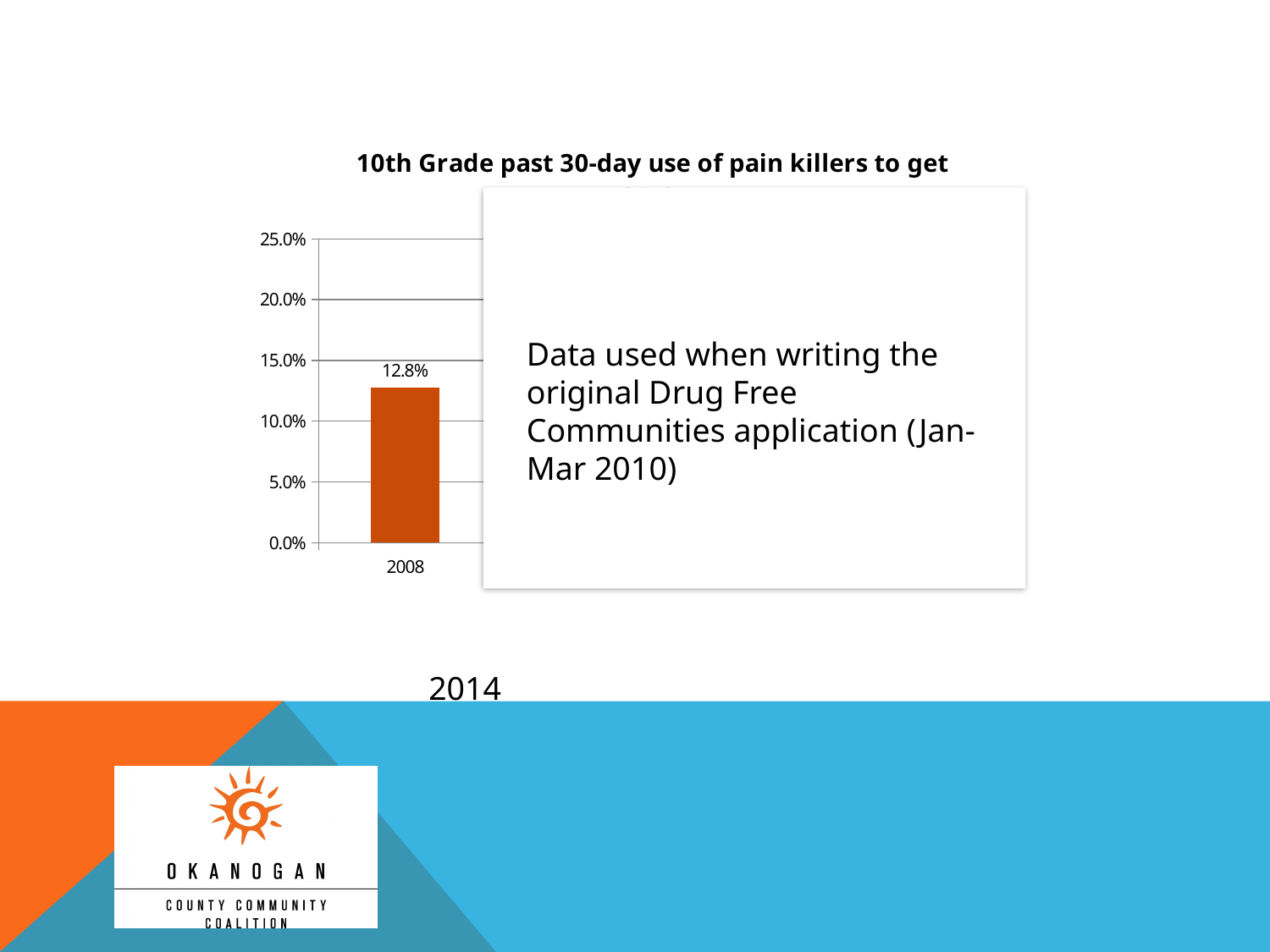
Is the value for 2008 greater or less than 15.0%? less What kind of chart is shown on the slide? bar chart What colour is the bar for 2008? orange What is the highest value shown on the chart's vertical axis? 25.0% What is the value for 2008 in the chart? 12.8% Is the value for 2008 greater or less than 20.0%? less Is the value for 2008 greater or less than 10.0%? greater